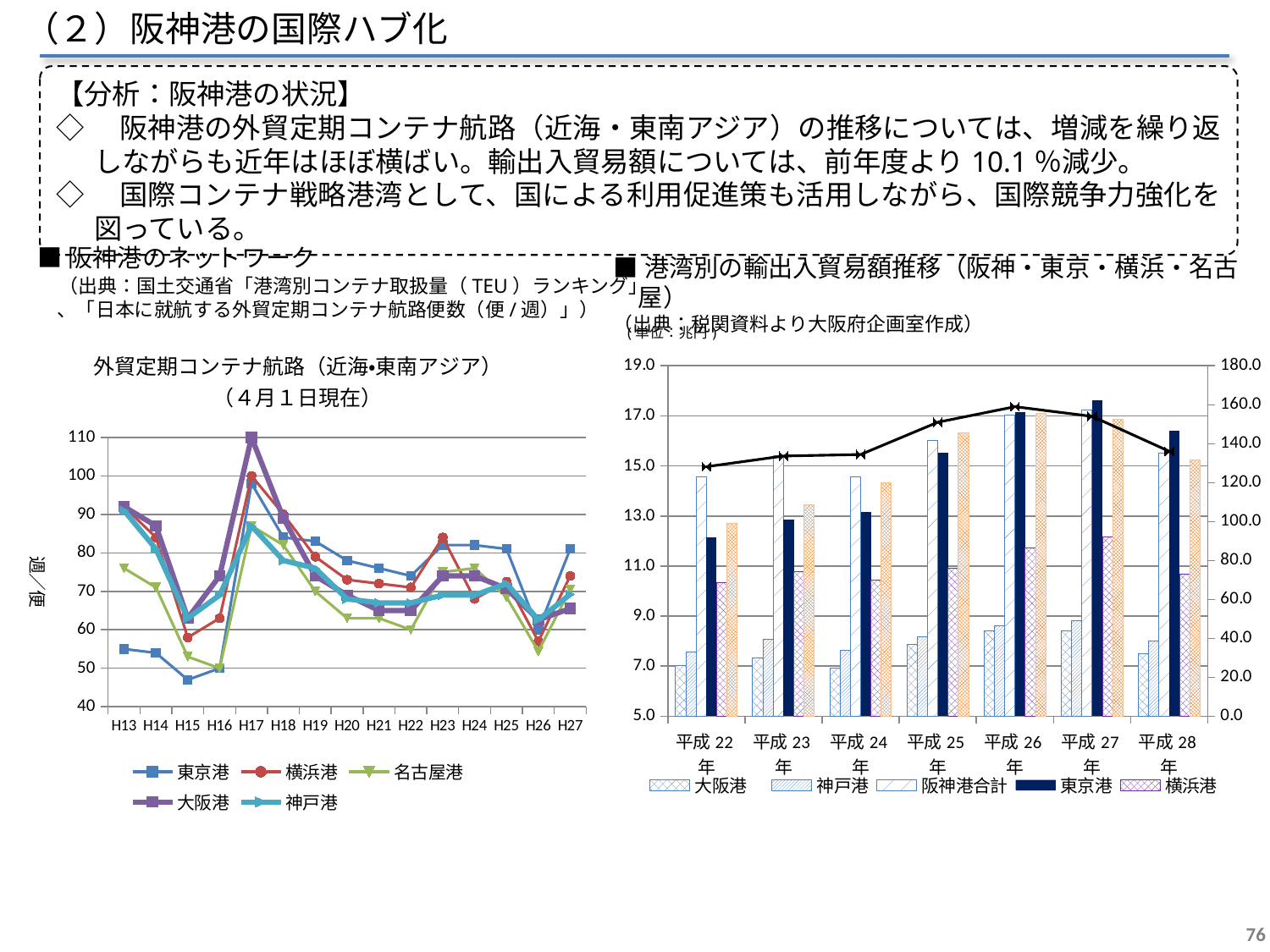
In the right chart 港湾別の輸出入貿易額推移, in 平成26年, which is larger: 東京港 or 横浜港? 東京港 What kind of chart is the left chart titled 外貿定期コンテナ航路（近海•東南アジア）? line chart In the left chart 外貿定期コンテナ航路（近海•東南アジア）, what is the label on the vertical axis? 週／便 In the left chart 外貿定期コンテナ航路（近海•東南アジア）, how many series does the legend list? 5 In the left chart 外貿定期コンテナ航路（近海•東南アジア）, which port has the lowest value at H15? 東京港 In the left chart 外貿定期コンテナ航路（近海•東南アジア）, which port has the highest value at H17? 大阪港 In the left chart 外貿定期コンテナ航路（近海•東南アジア）, is the value for 東京港 at H15 greater or less than 50? less In the right chart 港湾別の輸出入貿易額推移, how many years are shown on the x axis? 7 In the left chart 外貿定期コンテナ航路（近海•東南アジア）, how many years are shown on the x axis? 15 In the right chart 港湾別の輸出入貿易額推移, is the value for 東京港 in 平成22年 greater or less than 13.0? less In the left chart 外貿定期コンテナ航路（近海•東南アジア）, is the value for 大阪港 at H17 greater or less than 100? greater In the left chart 外貿定期コンテナ航路（近海•東南アジア）, at H13, which is larger: 東京港 or 大阪港? 大阪港